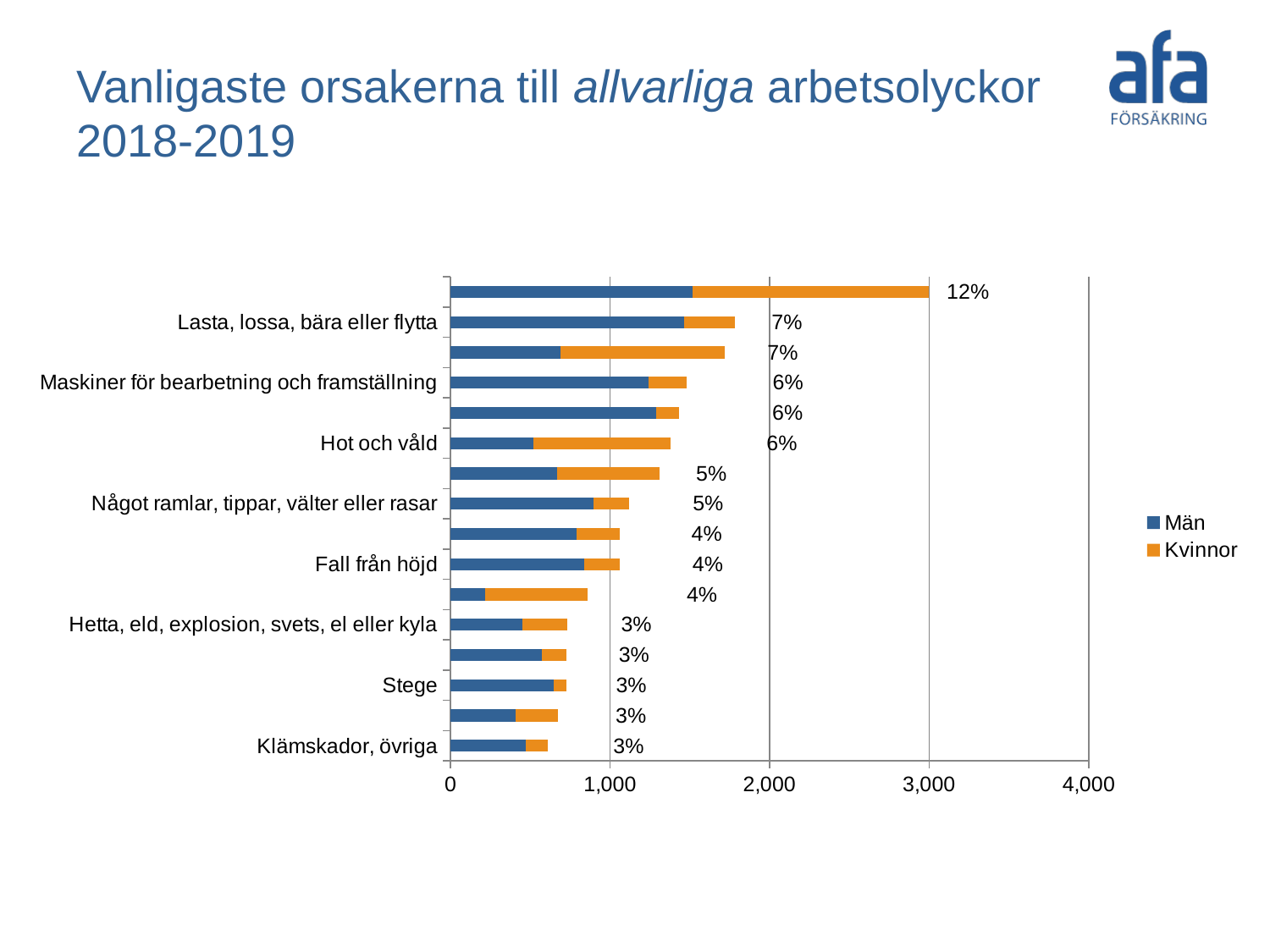
What percentage is shown for 'Hot och våld'? 6% What are the two series named in the legend? Män and Kvinnor What kind of chart is shown on the slide? Bar chart What percentage is shown for 'Lasta, lossa, bära eller flytta'? 7% For 'Hot och våld', which segment is larger, Män or Kvinnor? Kvinnor Is the total bar length for 'Klämskador, övriga' greater or less than 1,000? less How many series does the legend list? 2 What percentage is shown for 'Fall från höjd'? 4% Is the total bar length for 'Lasta, lossa, bära eller flytta' greater or less than 1,000? greater How many bars are plotted in the chart? 16 What is the highest percentage label shown on any bar in the chart? 12% What percentage is shown for 'Stege'? 3%